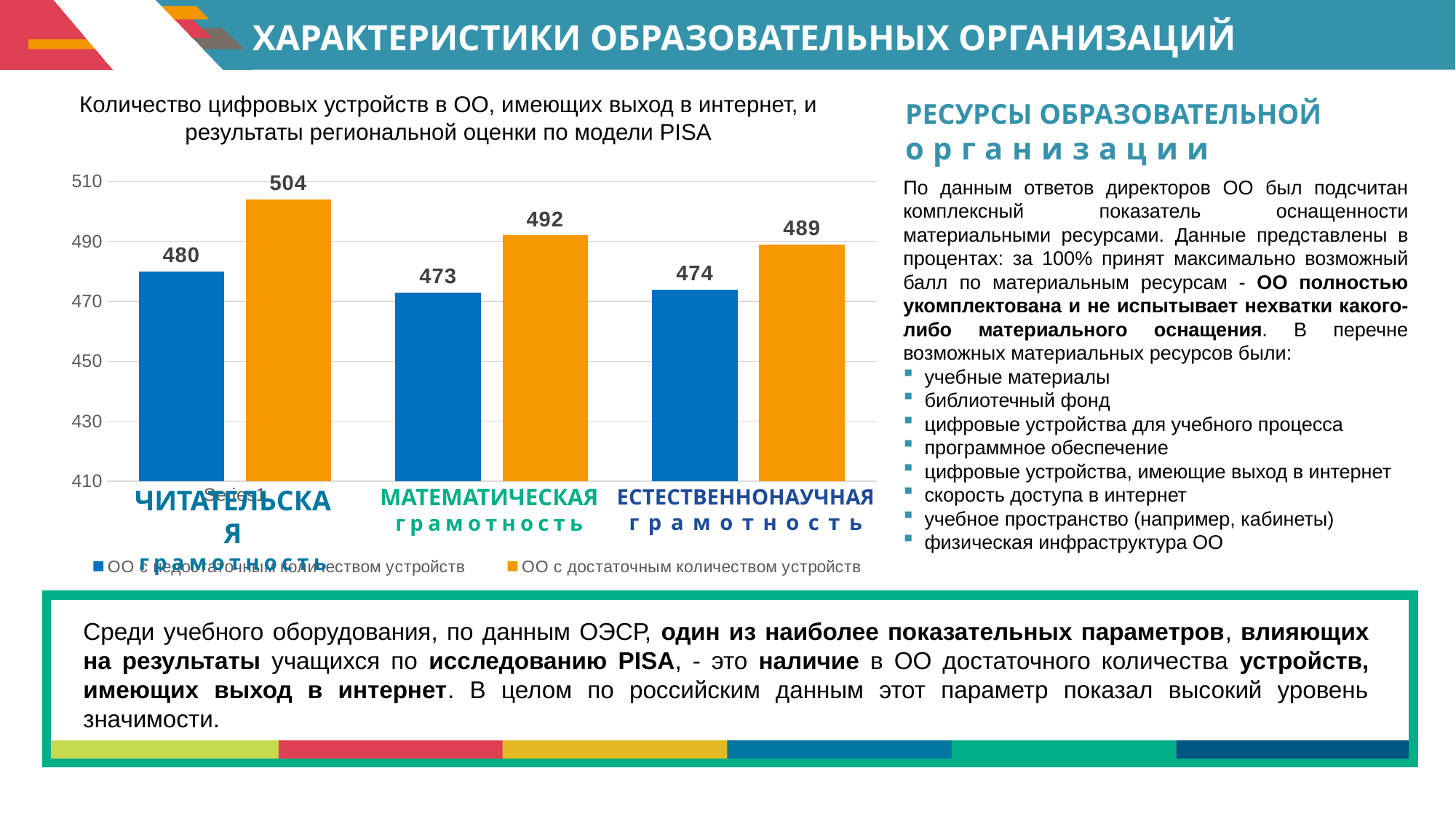
Which colour represents the series 'ОО с достаточным количеством устройств' in the chart? Orange How many categories (literacy types) are shown on the x axis of the chart? 3 What is the value of the blue bar for Математическая грамотность? 473 What is the difference between the orange and blue bars for Математическая грамотность? 19 Which is larger: the blue bar for Читательская грамотность or the orange bar for Естественнонаучная грамотность? The orange bar for Естественнонаучная грамотность (489) What is the value of the orange bar (ОО с достаточным количеством устройств) for Естественнонаучная грамотность? 489 What type of chart is shown on the slide? Bar chart How many series does the chart legend list? 2 What is the difference between the orange and blue bars for Читательская грамотность? 24 Which category has the lowest value for the blue series? Математическая грамотность Which category has the highest value for the orange series (ОО с достаточным количеством устройств)? Читательская грамотность What is the value of the orange bar (ОО с достаточным количеством устройств) for Читательская грамотность? 504